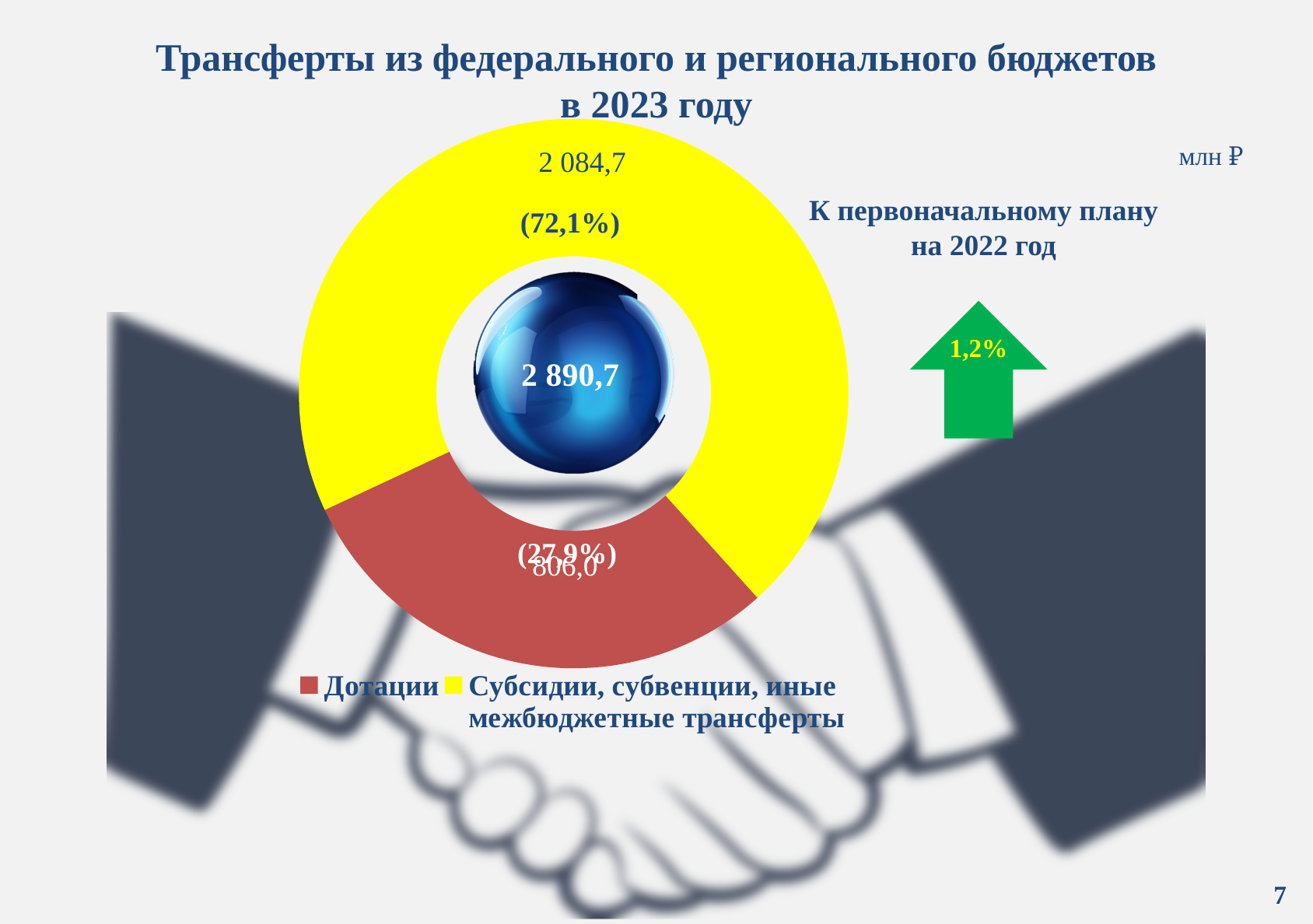
Which category has the smallest slice of the pie? Дотации What kind of chart is shown on the slide? Doughnut chart What is the value for Субсидии, субвенции, иные межбюджетные трансферты? 2 084,7 Which is larger, Дотации or Субсидии, субвенции, иные межбюджетные трансферты? Субсидии, субвенции, иные межбюджетные трансферты How many categories does the pie chart show? 2 What share of the pie does Субсидии, субвенции, иные межбюджетные трансферты take? 72,1% What share of the pie does Дотации take? 27,9% How many entries does the legend list? 2 Which category has the largest slice of the pie? Субсидии, субвенции, иные межбюджетные трансферты What is the value for Дотации? 806,0 What colour is the Дотации slice? Red What total value is shown in the centre of the chart? 2 890,7